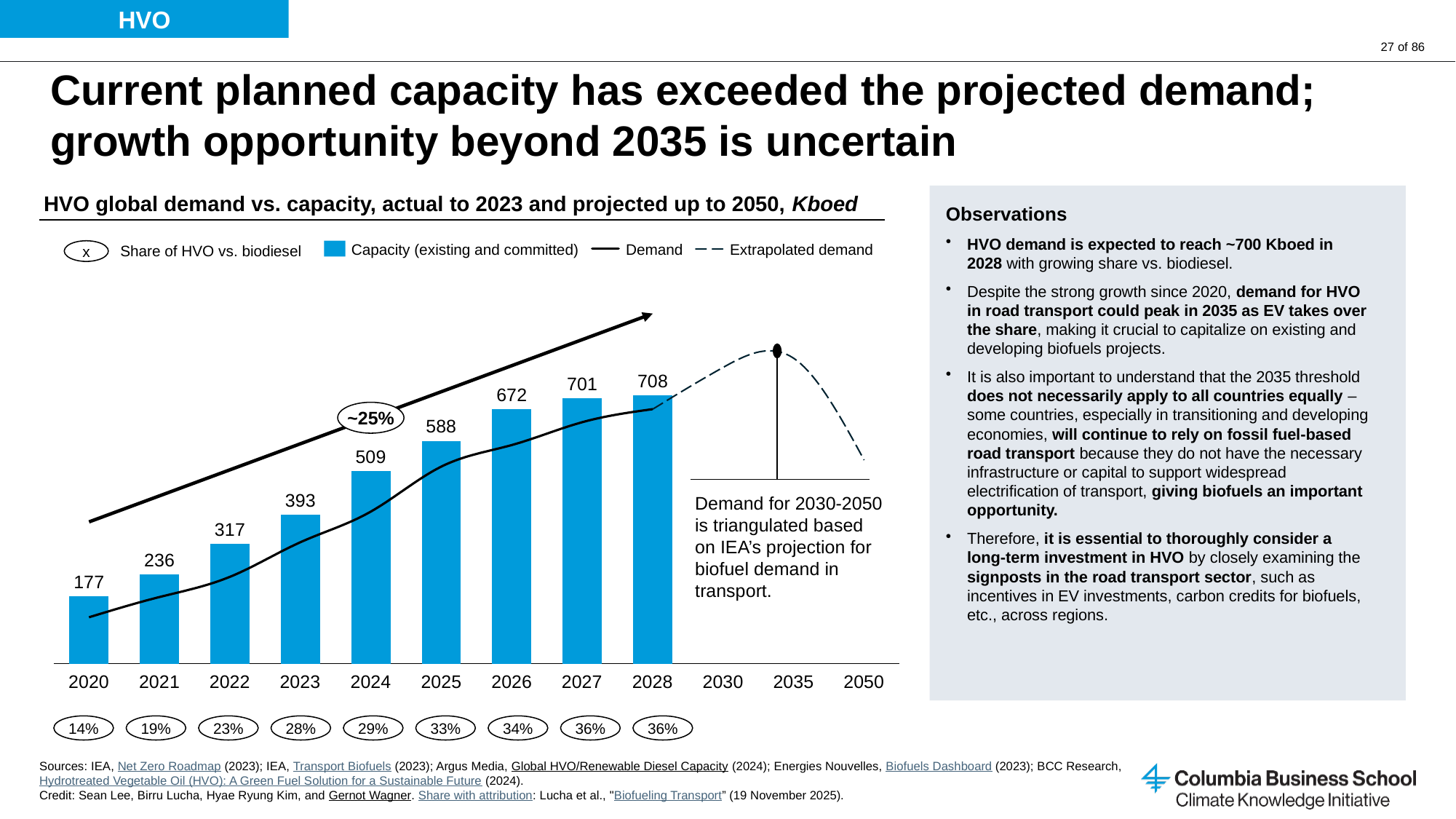
How many entries does the legend list? 4 What is the difference between the capacity values for 2025 and 2023? 195 What share of HVO vs. biodiesel is shown for 2025? 33% What is the capacity value shown for 2020? 177 What is the difference between the capacity values for 2028 and 2027? 7 Which year has the lowest capacity bar? 2020 Which is larger, the capacity value for 2022 or for 2023? 2023 What is the capacity (existing and committed) value shown for 2024? 509 What kind of chart is used to show capacity? Bar chart Which year has the highest capacity bar? 2028 How many capacity bars are plotted on the chart? 9 Do the capacity values rise or fall from 2020 to 2028? Rise